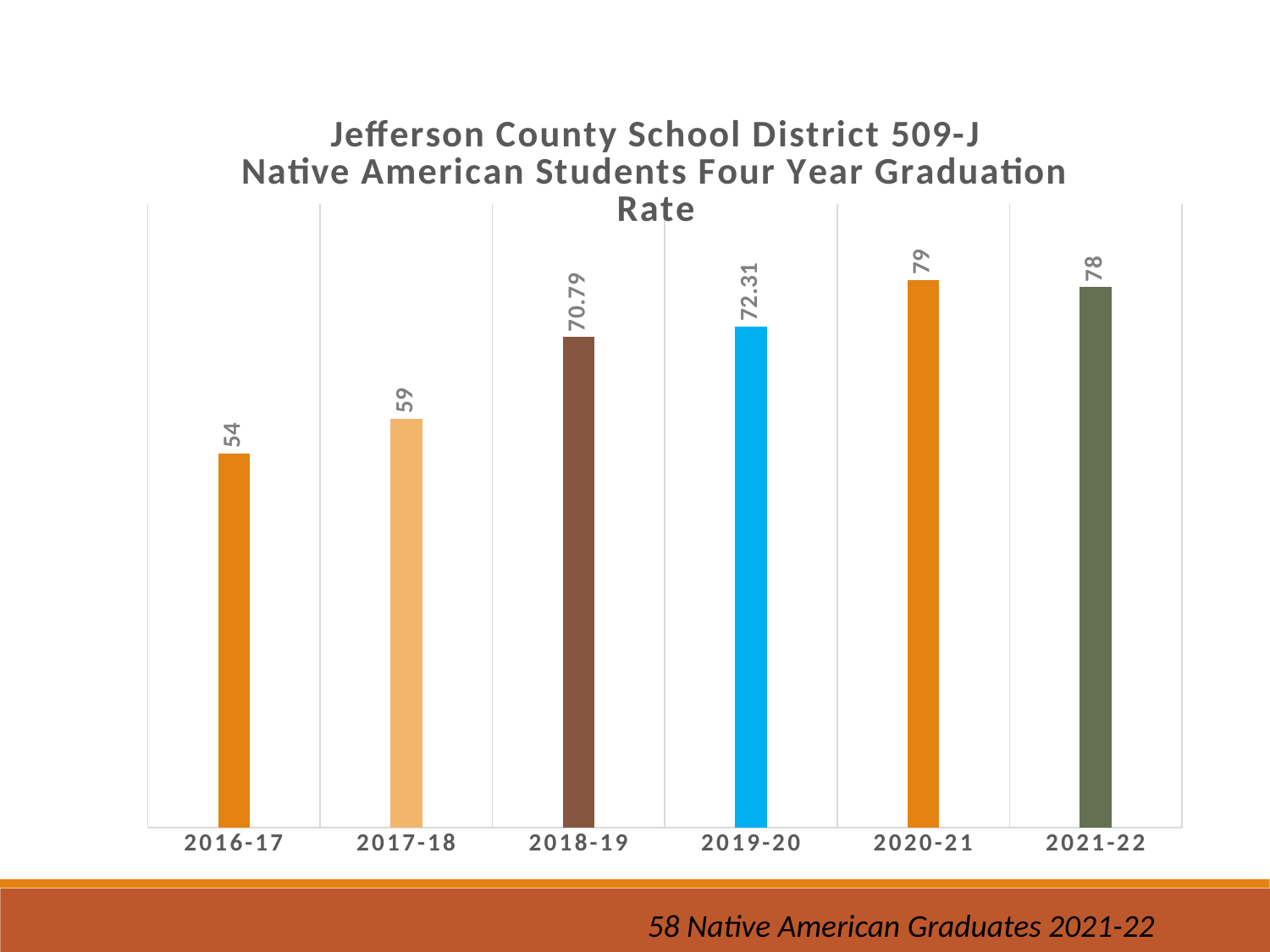
Which school year has the lowest graduation rate? 2016-17 What is the graduation rate for 2019-20? 72.31 What kind of chart is shown on the slide? Bar chart What is the graduation rate for 2018-19? 70.79 What is the difference between the graduation rates for 2017-18 and 2016-17? 5 Which school year has the highest graduation rate? 2020-21 What is the difference between the graduation rates for 2020-21 and 2016-17? 25 How many school years are shown on the chart? 6 Which is larger, the graduation rate for 2018-19 or for 2017-18? 2018-19 What is the graduation rate for 2021-22? 78 Does the graduation rate generally rise or fall from 2016-17 to 2020-21? Rise What is the graduation rate for 2016-17? 54